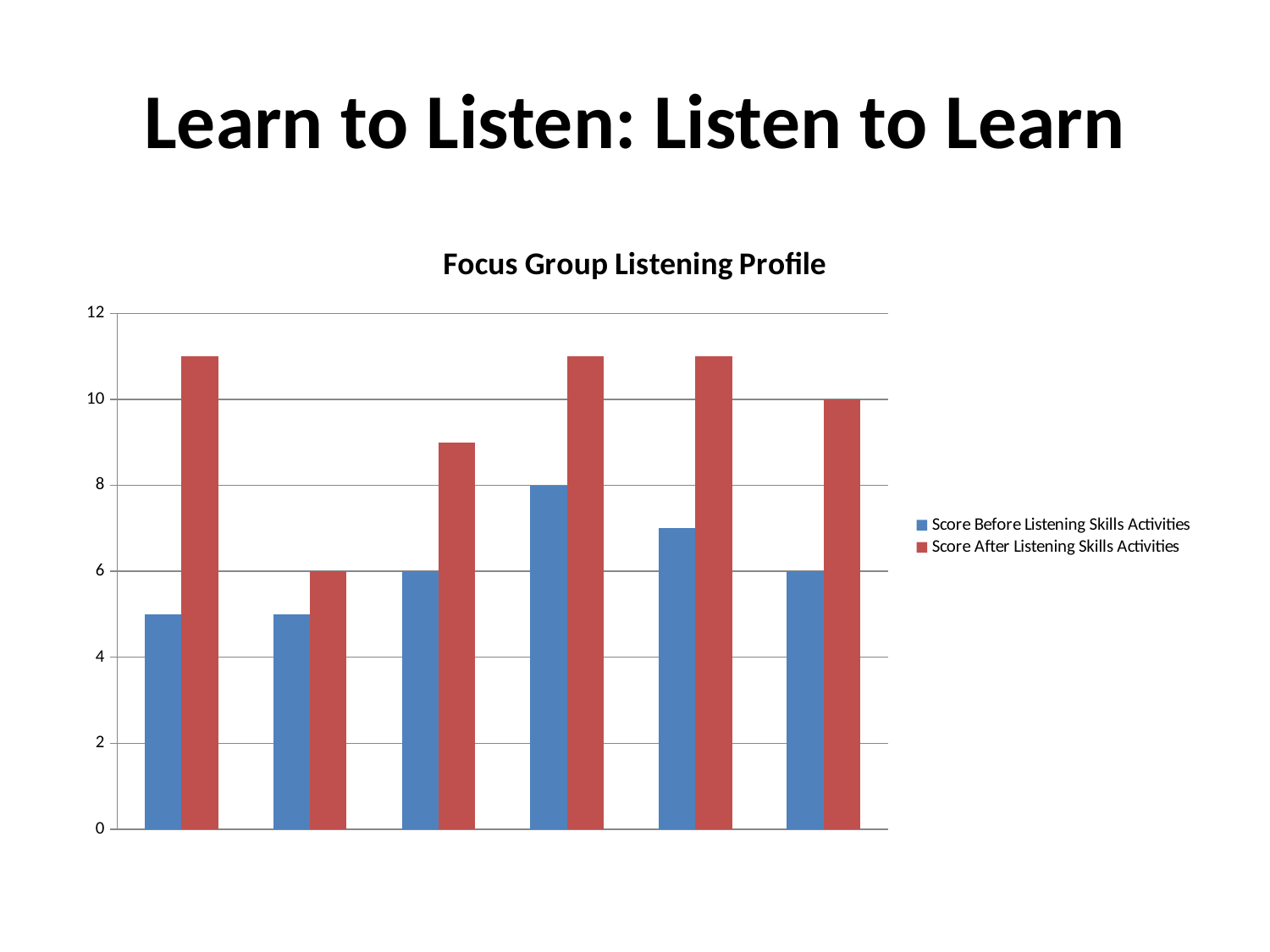
In the sixth group of bars from the left, what is the difference between the Score After and the Score Before Listening Skills Activities? 4 What kind of chart is shown on the slide? bar chart What is the Score After Listening Skills Activities for the second group of bars from the left? 6 How many groups of bars are plotted in the chart? 6 Which series is shown in red? Score After Listening Skills Activities What is the title of the chart? Focus Group Listening Profile Which group of bars has the highest Score Before Listening Skills Activities? the fourth group from the left Is the Score After Listening Skills Activities for the first group of bars greater or less than 10? greater Is the Score Before Listening Skills Activities for the first group of bars greater or less than 6? less How many series does the legend list? 2 What is the Score Before Listening Skills Activities for the fourth group of bars from the left? 8 What is the Score After Listening Skills Activities for the sixth group of bars from the left? 10